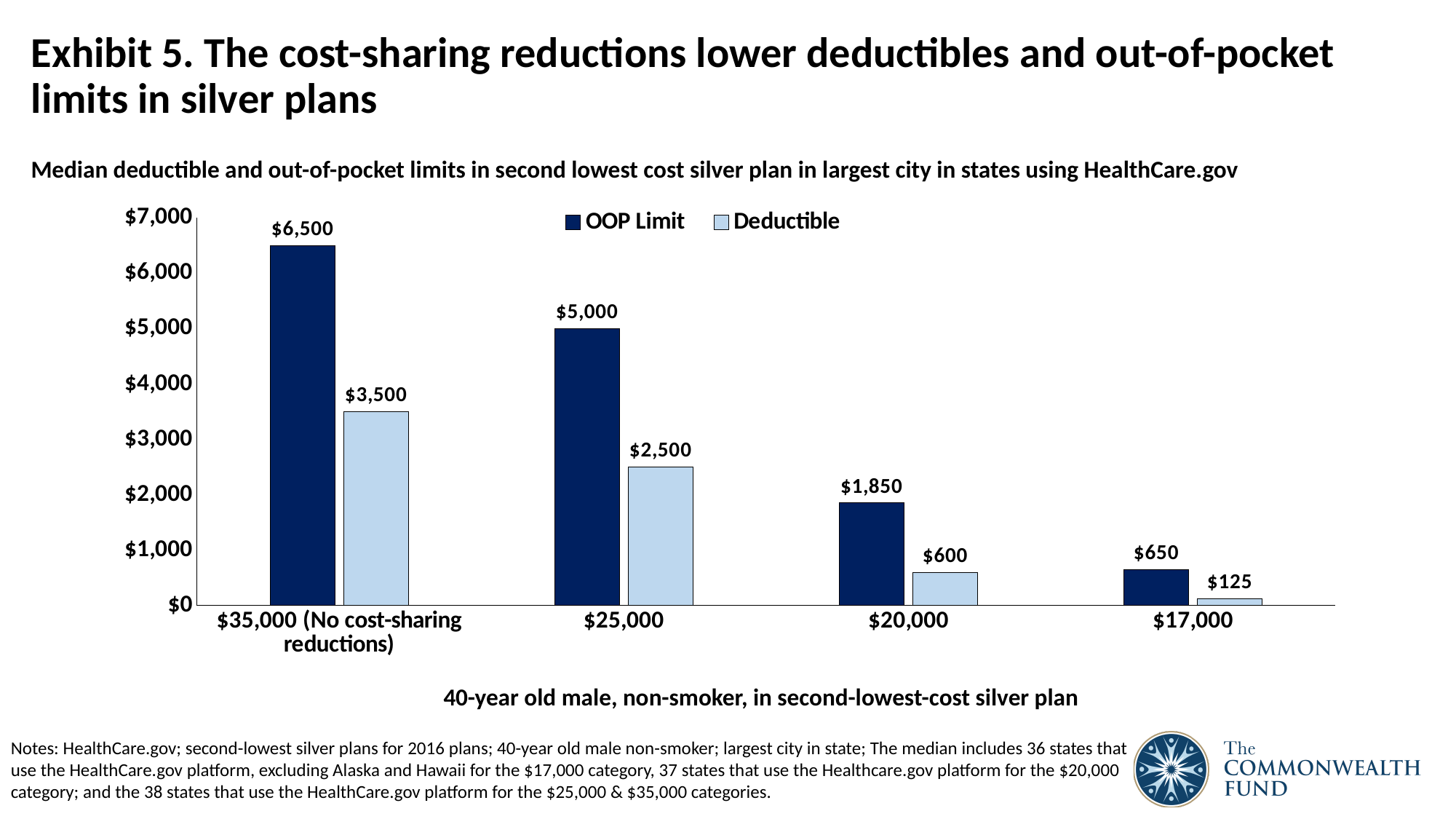
What is the OOP Limit for the $35,000 (No cost-sharing reductions) income category? $6,500 What is the Deductible for the $25,000 income category? $2,500 What is the difference between the OOP Limit for the $35,000 category and the OOP Limit for the $17,000 category? $5,850 What is the difference between the OOP Limit and the Deductible for the $25,000 income category? $2,500 Which is larger: the Deductible for $35,000 or the OOP Limit for $25,000? OOP Limit for $25,000 What is the OOP Limit for the $20,000 income category? $1,850 Do the OOP Limit values rise or fall moving from left to right along the x axis? fall How many series does the legend list? 2 How many income categories are shown on the x axis? 4 Which income category has the highest OOP Limit? $35,000 (No cost-sharing reductions) Which income category has the lowest Deductible? $17,000 What is the Deductible for the $17,000 income category? $125